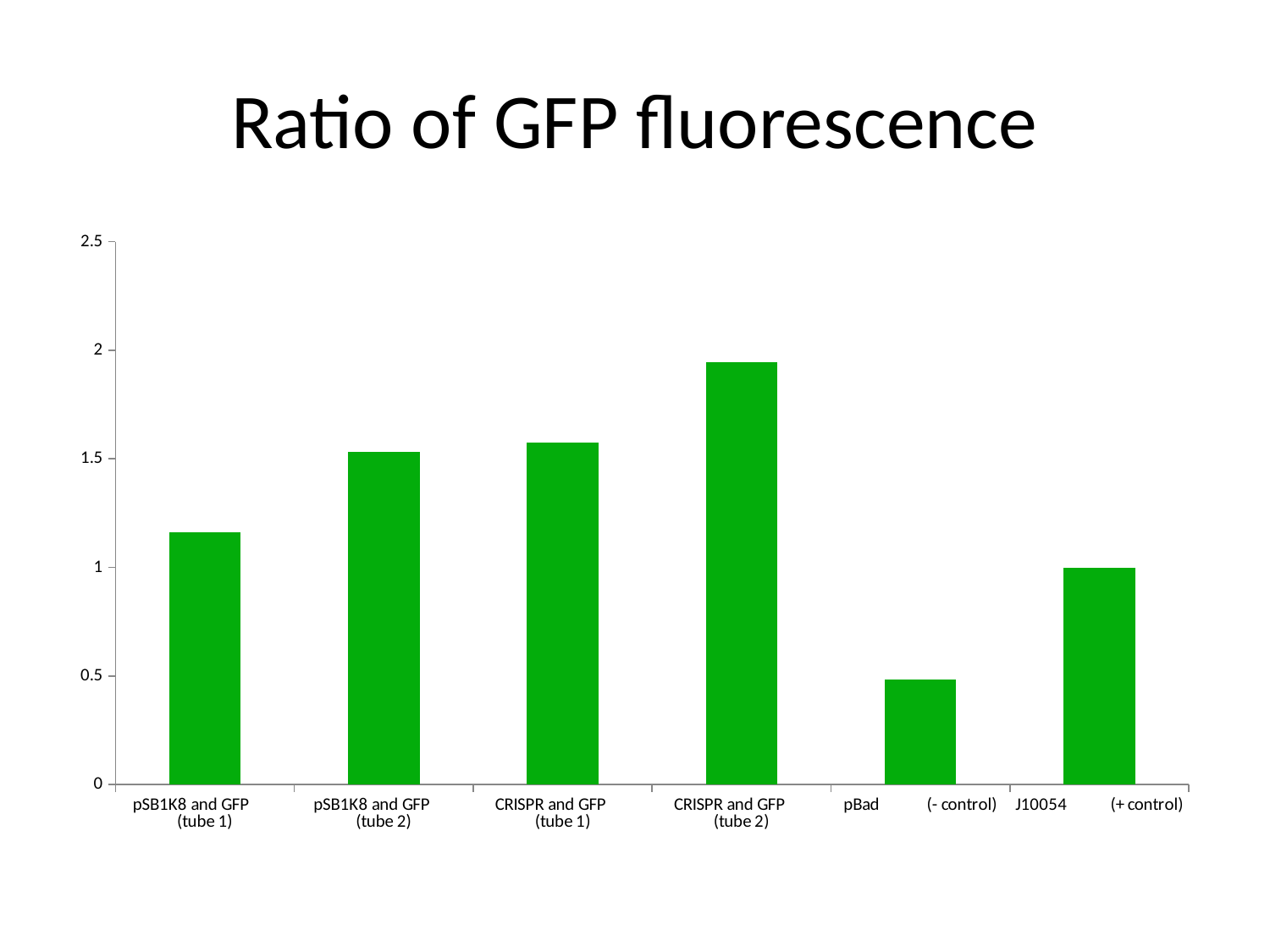
Which is larger, the value for J10054 (+ control) or the value for pBad (- control)? J10054 (+ control) What colour are the bars in the chart? green Which is larger, the value for pSB1K8 and GFP (tube 1) or the value for CRISPR and GFP (tube 1)? CRISPR and GFP (tube 1) What kind of chart is shown on the slide? bar chart How many bars are plotted in the chart? 6 Is the value for CRISPR and GFP (tube 2) greater or less than 2? less What is the title of the chart? Ratio of GFP fluorescence Is the value for pSB1K8 and GFP (tube 1) greater or less than 1? greater Which category has the lowest ratio of GFP fluorescence? pBad (- control) Which category has the highest ratio of GFP fluorescence? CRISPR and GFP (tube 2) Is the value for pSB1K8 and GFP (tube 2) greater or less than 1? greater